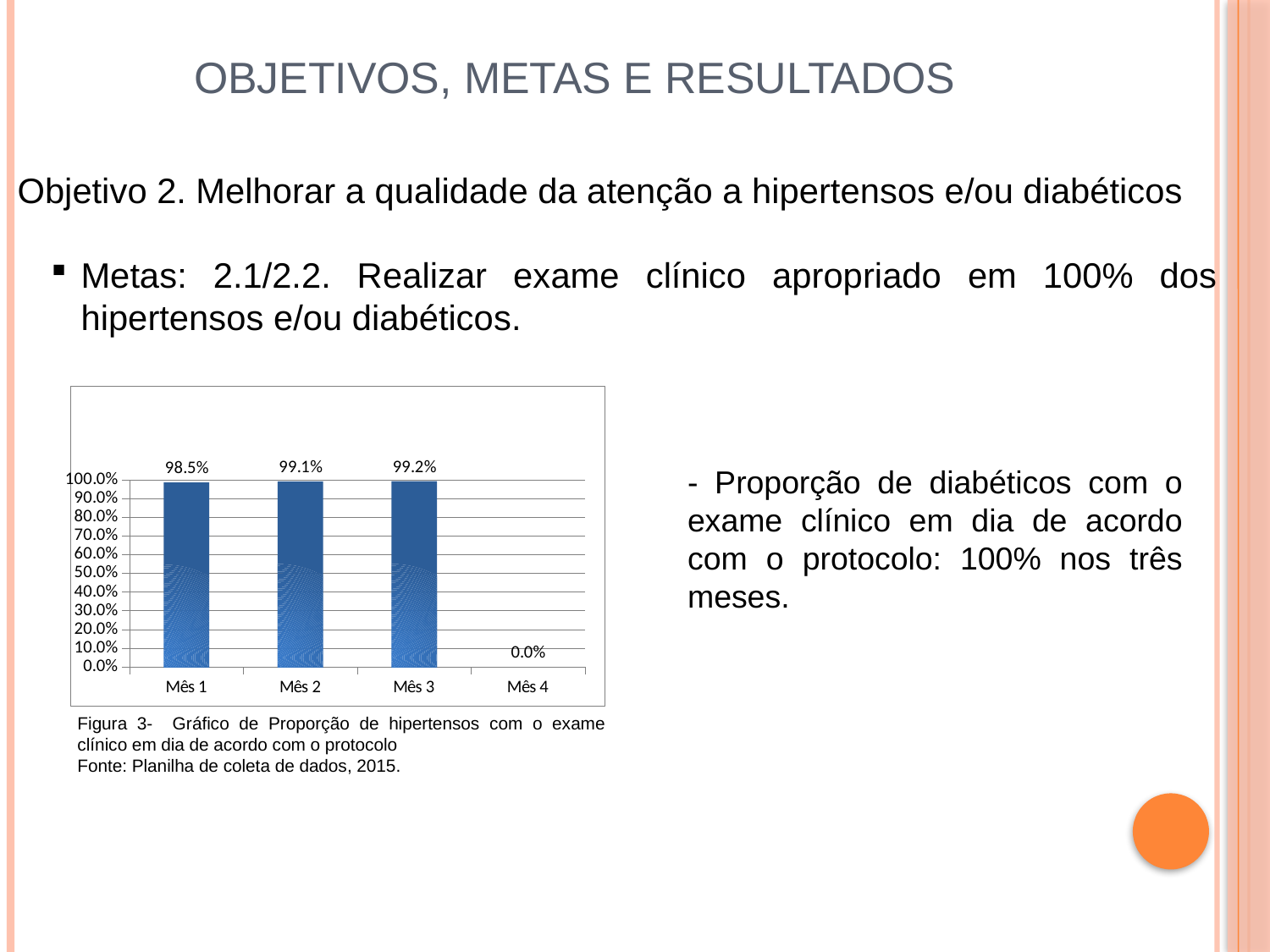
Which category has the lowest value? Mês 4 What is the difference between the values for Mês 3 and Mês 1? 0.7% What is the value for Mês 3? 99.2% Which is larger, the value for Mês 2 or the value for Mês 1? Mês 2 What kind of chart is shown on the slide? bar chart How many categories are shown on the x axis? 4 Which category has the highest value? Mês 3 Is the value for Mês 1 greater or less than 90.0%? greater Do the values rise or fall from Mês 1 to Mês 3? rise What is the value for Mês 2? 99.1% What is the value for Mês 1? 98.5% What is the value for Mês 4? 0.0%